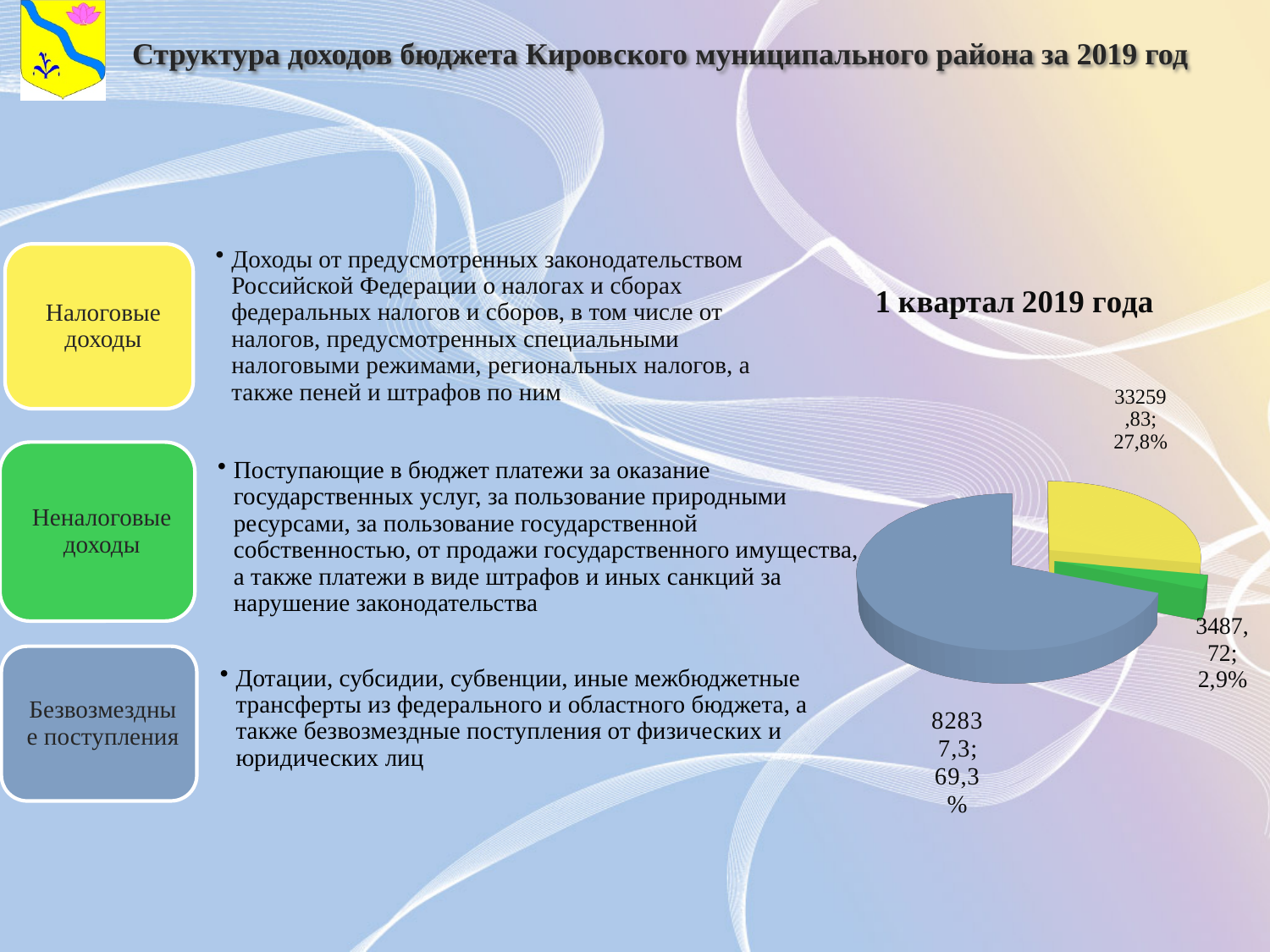
Which slice of the pie chart is the largest? the blue slice (69,3%) What is the sum of the three values labelled on the pie chart? 119584,85 How many slices does the pie chart have? 3 What value is labelled on the green slice of the pie chart? 3487,72 Which slice of the pie chart is the smallest? the green slice (2,9%) What is the difference in percentage points between the yellow slice's share and the green slice's share? 24,9% What percentage share is labelled on the blue slice of the pie chart? 69,3% What kind of chart is shown on the slide? pie chart Which slice has the larger share, the yellow slice or the green slice? the yellow slice What is the title of the pie chart? 1 квартал 2019 года What percentage share is labelled on the yellow slice of the pie chart? 27,8% What value is labelled on the blue slice of the pie chart? 82837,3